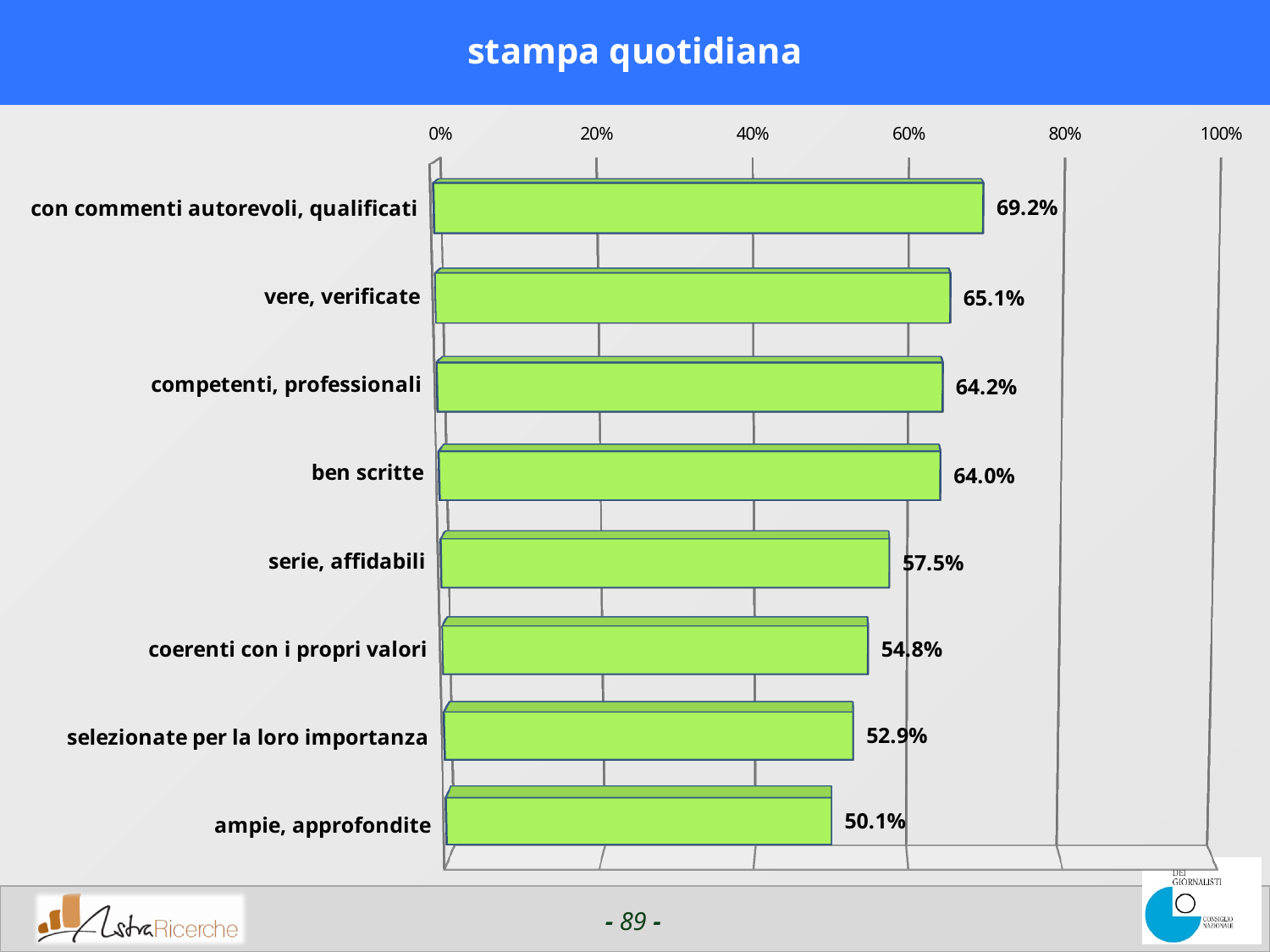
What is the difference between the values for "vere, verificate" and "serie, affidabili"? 7.6% What is the value for "serie, affidabili"? 57.5% How many categories are shown in the chart? 8 What is the value for "vere, verificate"? 65.1% What kind of chart is shown on the slide? bar chart Which is larger, the value for "coerenti con i propri valori" or the value for "selezionate per la loro importanza"? coerenti con i propri valori What is the value for "ampie, approfondite"? 50.1% Which category has the highest value? con commenti autorevoli, qualificati Is the value for "ben scritte" greater or less than 60%? greater Which category has the lowest value? ampie, approfondite What is the title of the chart? stampa quotidiana What is the difference between the values for "con commenti autorevoli, qualificati" and "ampie, approfondite"? 19.1%